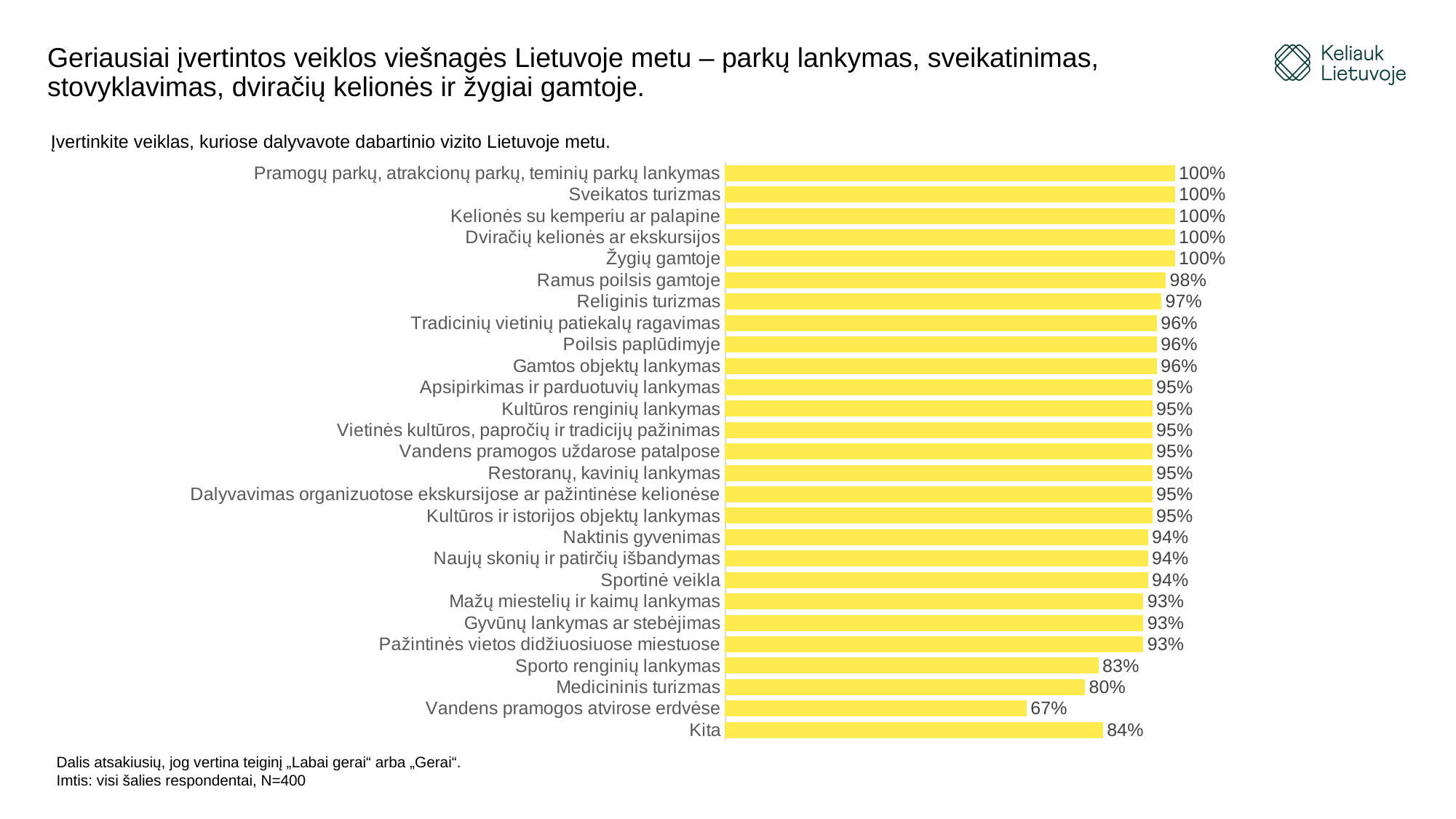
Which category has the lowest value? Vandens pramogos atvirose erdvėse Which is larger, the value for Sporto renginių lankymas or the value for Kita? Kita What is the difference between the values for Religinis turizmas and Medicininis turizmas? 17% What is the value for Ramus poilsis gamtoje? 98% What is the value for Medicininis turizmas? 80% What kind of chart is shown on the slide? Bar chart What is the value for Sporto renginių lankymas? 83% What is the value for Kita? 84% How many categories are shown in the chart? 27 What is the value for Naktinis gyvenimas? 94% What colour are the bars in the chart? Yellow How many categories have a value of 100%? 5